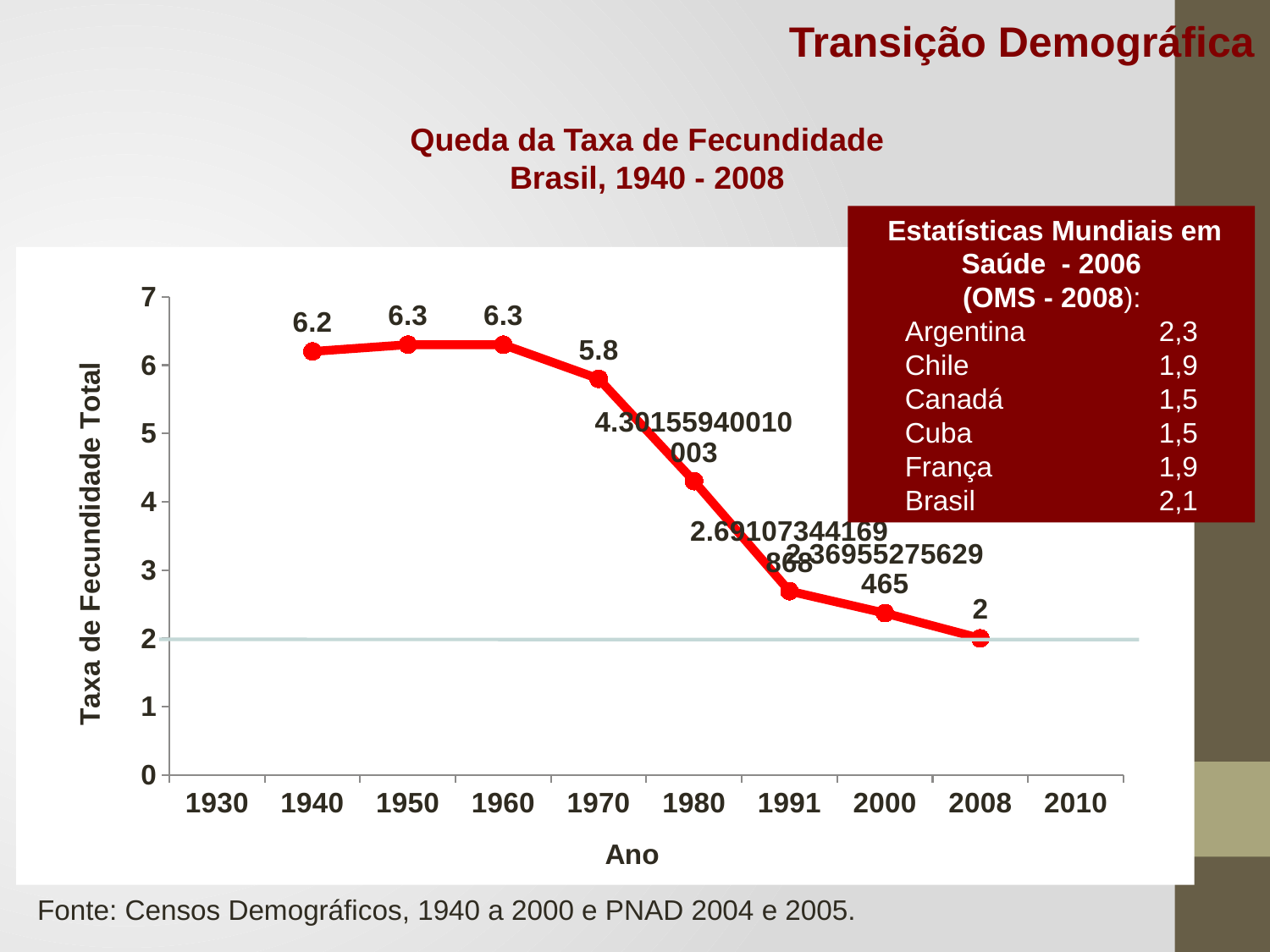
What is the total fertility rate shown for 1950? 6.3 What is the total fertility rate shown for 1940? 6.2 Does the fertility rate rise or fall from 1960 to 2008? fall Is the value for 1991 greater or less than 3? less What kind of chart is shown on the slide? line chart What is the total fertility rate shown for 2008? 2 How many data points are plotted on the line? 8 Which year has the larger fertility rate, 1940 or 1970? 1940 What is the difference between the fertility rate in 1940 and in 1970? 0.4 Which year has the lowest total fertility rate on the chart? 2008 What is the difference between the fertility rate in 1960 and in 2008? 4.3 What is the total fertility rate shown for 1970? 5.8